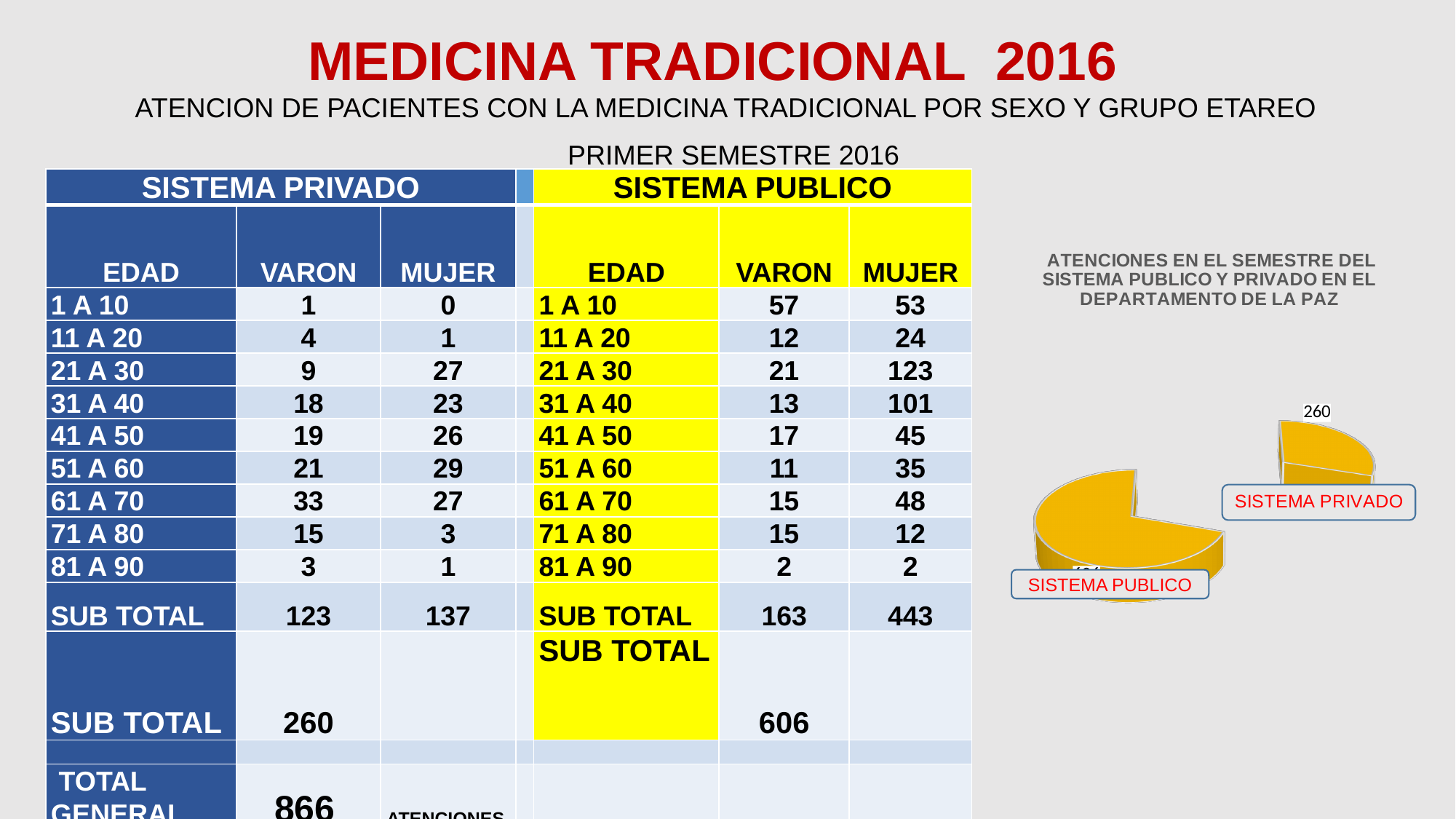
What are the names of the two slices in the pie chart? SISTEMA PRIVADO and SISTEMA PUBLICO What kind of chart is shown on the right side of the slide? pie chart What is the title of the pie chart? ATENCIONES EN EL SEMESTRE DEL SISTEMA PUBLICO Y PRIVADO EN EL DEPARTAMENTO DE LA PAZ In the pie chart, which is larger, SISTEMA PUBLICO or SISTEMA PRIVADO? SISTEMA PUBLICO Which slice of the pie chart is the smallest? SISTEMA PRIVADO How many slices does the pie chart have? 2 What value is labelled on the SISTEMA PRIVADO slice of the pie chart? 260 Which slice of the pie chart is the largest? SISTEMA PUBLICO